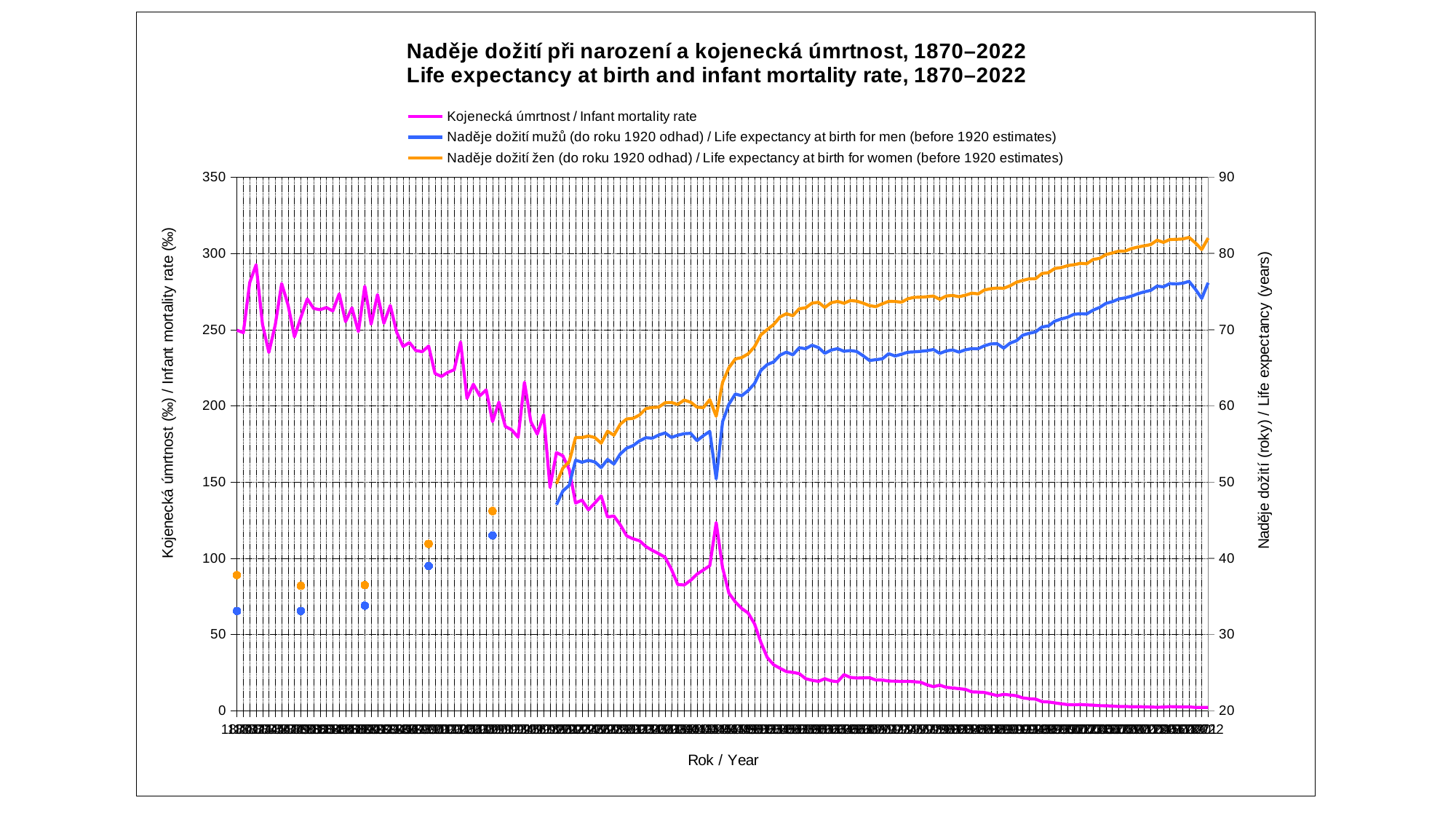
At the start of the period (1870), which is higher: life expectancy for men or for women? women Is the infant mortality rate at the end of the period (2022) greater or less than 50‰? less At the end of the period (2022), which is higher: life expectancy for men or for women? women What is the English part of the chart title? Life expectancy at birth and infant mortality rate, 1870–2022 Is life expectancy at birth for men at the end of the period (2022) greater or less than 70 years? greater What colour is the line for the infant mortality rate? magenta Does life expectancy at birth for women generally rise or fall over the period shown? rise Is the infant mortality rate at the start of the period (1870) greater or less than 200‰? greater What kind of chart is shown on the slide? line chart Does the infant mortality rate generally rise or fall from 1870 to 2022? fall How many series does the legend list? 3